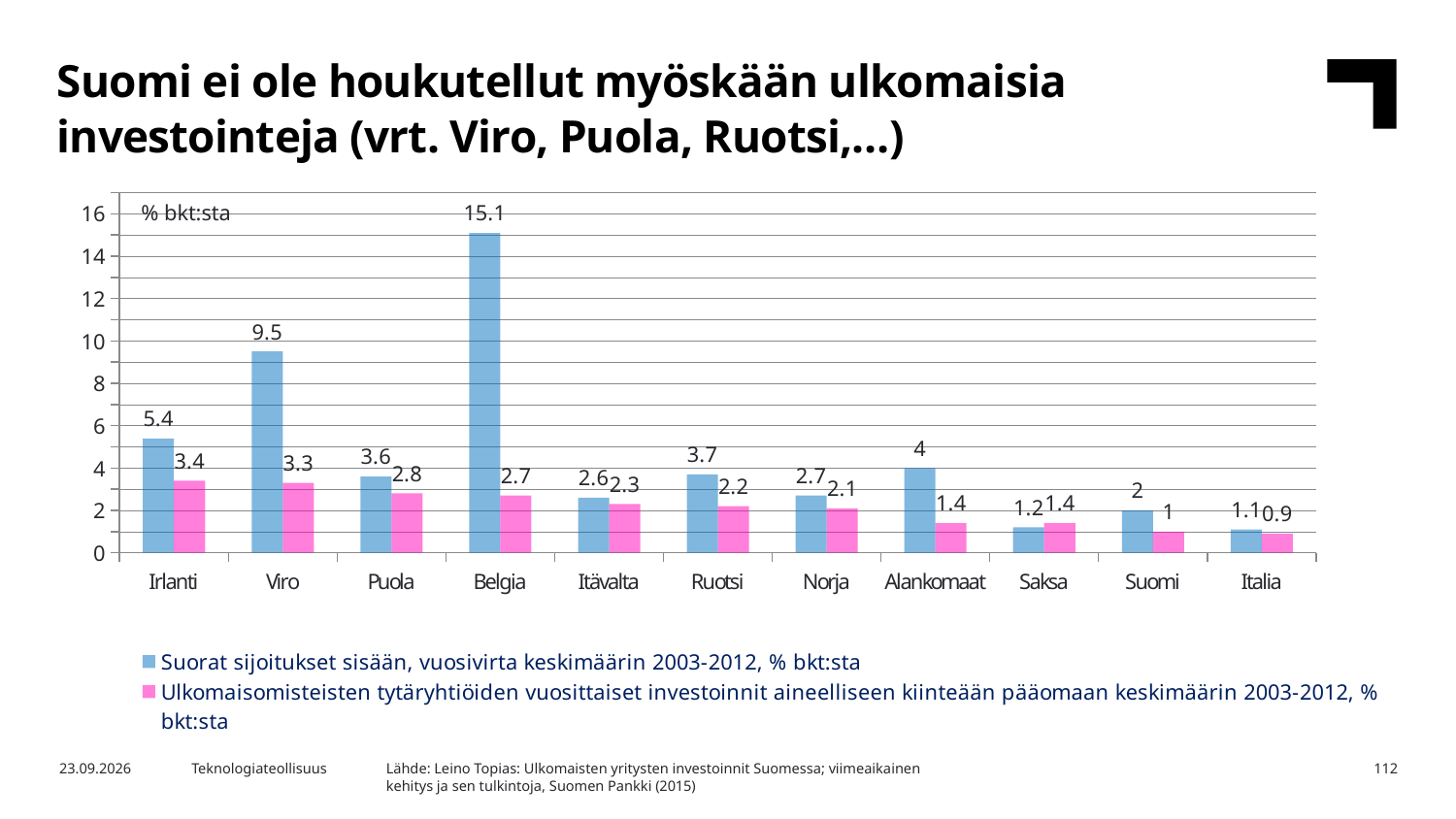
What unit label is shown at the top left of the chart's plot area? % bkt:sta Which country has the lowest value in the pink series (Ulkomaisomisteisten tytäryhtiöiden investoinnit)? Italia How many series does the chart legend list? 2 What is the difference between the blue series values for Viro and Suomi? 7.5 What is the value of the blue series (Suorat sijoitukset sisään) for Belgia? 15.1 Which country has the highest value in the blue series (Suorat sijoitukset sisään)? Belgia Which is larger for Saksa: the blue series value or the pink series value? The pink series value (1.4) What is the value of the blue series (Suorat sijoitukset sisään) for Viro? 9.5 How many countries are shown on the x axis of the chart? 11 What is the value of the pink series (Ulkomaisomisteisten tytäryhtiöiden investoinnit) for Suomi? 1 What kind of chart is shown on the slide? Bar chart Is the blue series value for Irlanti greater or less than 4? greater